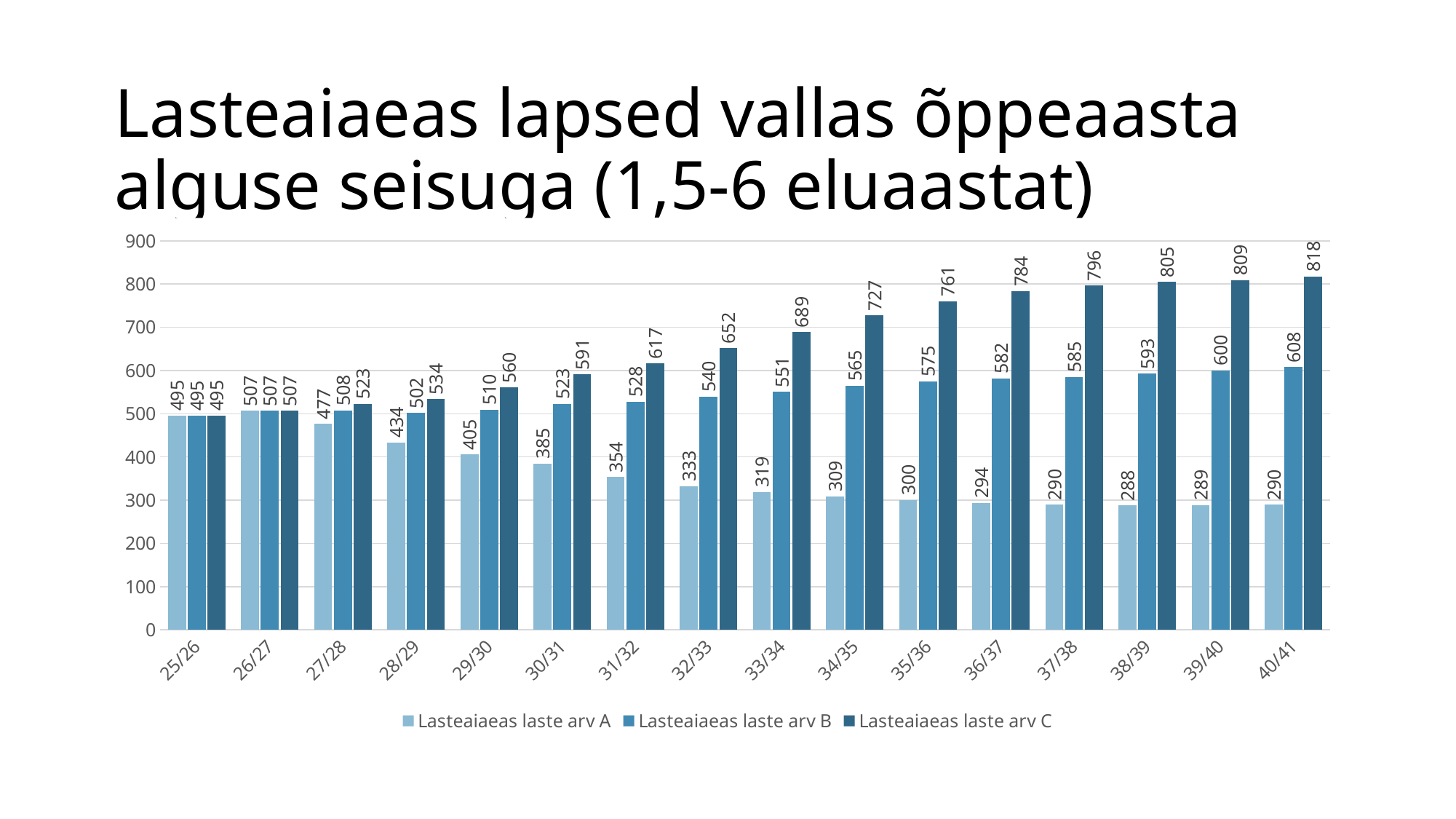
How many school years are shown on the x axis? 16 Which is larger for 29/30: Lasteaiaeas laste arv B or Lasteaiaeas laste arv A? Lasteaiaeas laste arv B What kind of chart is shown on the slide? Bar chart What is the value of Lasteaiaeas laste arv B for 33/34? 551 What is the value of Lasteaiaeas laste arv A for 30/31? 385 Which school year has the highest value for Lasteaiaeas laste arv C? 40/41 What is the value of Lasteaiaeas laste arv A for 25/26? 495 What is the value of Lasteaiaeas laste arv C for 40/41? 818 Does Lasteaiaeas laste arv C rise or fall from 25/26 to 40/41? Rise Which school year has the lowest value for Lasteaiaeas laste arv A? 38/39 How many series does the legend list? 3 What is the difference between Lasteaiaeas laste arv C and Lasteaiaeas laste arv A for 40/41? 528